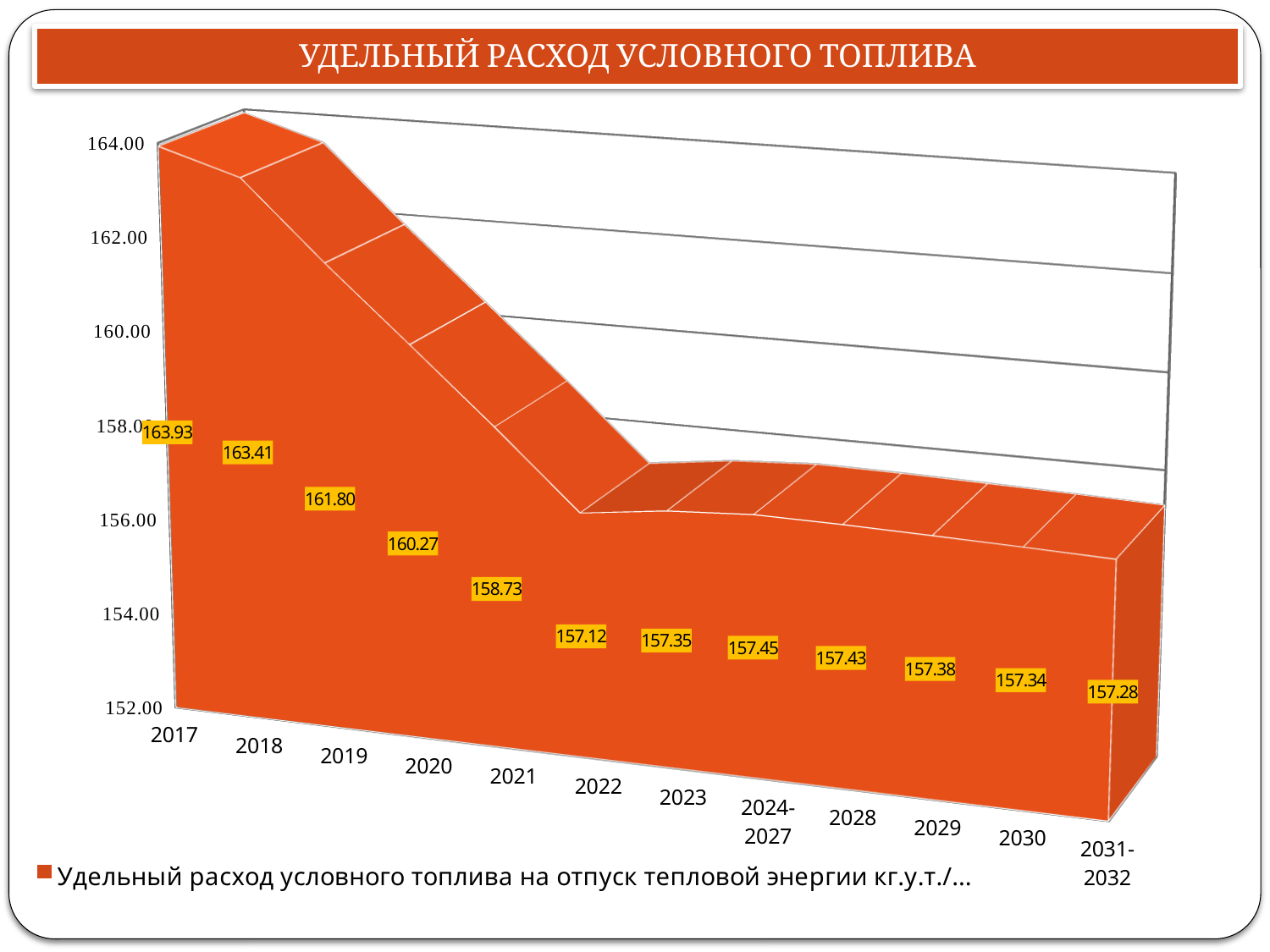
Which category has the lowest value? 2022 Which category has the highest value? 2017 What is the difference between the values for 2017 and 2018? 0.52 What is the value for 2024-2027? 157.45 What is the difference between the values for 2021 and 2022? 1.61 Do the values rise or fall from 2017 to 2022? fall What is the value for 2031-2032? 157.28 How many categories are shown on the x axis? 12 Which is larger, the value for 2019 or the value for 2020? 2019 What is the value for 2017? 163.93 What is the value for 2021? 158.73 What kind of chart is this? area chart